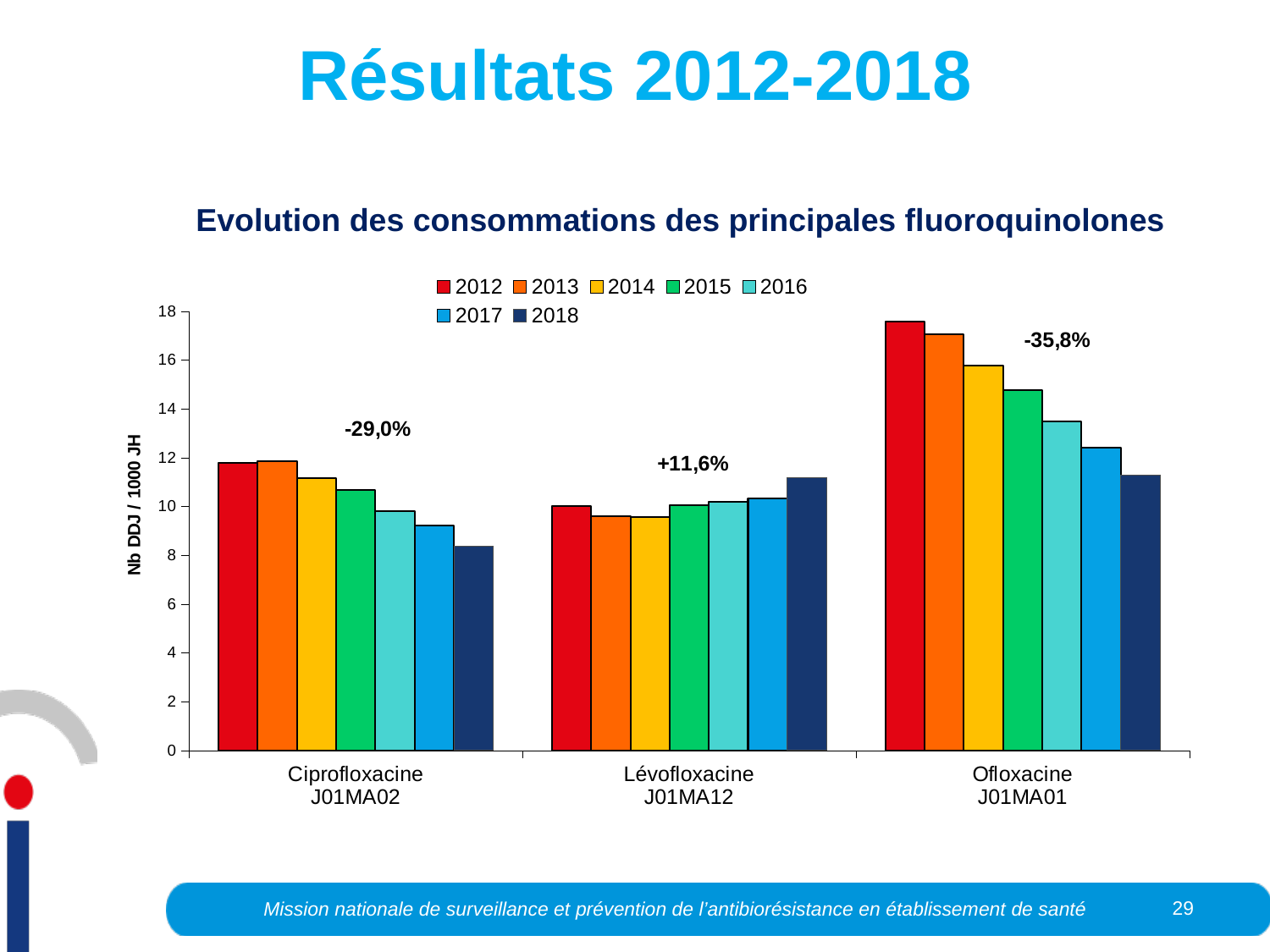
How many series does the legend list? 7 What percentage change is annotated above the Ciprofloxacine J01MA02 group? -29,0% What percentage change is annotated above the Ofloxacine J01MA01 group? -35,8% Which antibiotic has the lowest 2018 value? Ciprofloxacine J01MA02 How many antibiotic categories are shown on the x axis? 3 What percentage change is annotated above the Lévofloxacine J01MA12 group? +11,6% Is the 2012 value for Ofloxacine J01MA01 greater or less than 16? greater What is the label of the y axis? Nb DDJ / 1000 JH What kind of chart is shown on the slide? bar chart Do the values for Lévofloxacine J01MA12 rise or fall from 2014 to 2018? rise Which antibiotic has the highest 2012 value? Ofloxacine J01MA01 Is the 2018 value for Ciprofloxacine J01MA02 greater or less than 10? less